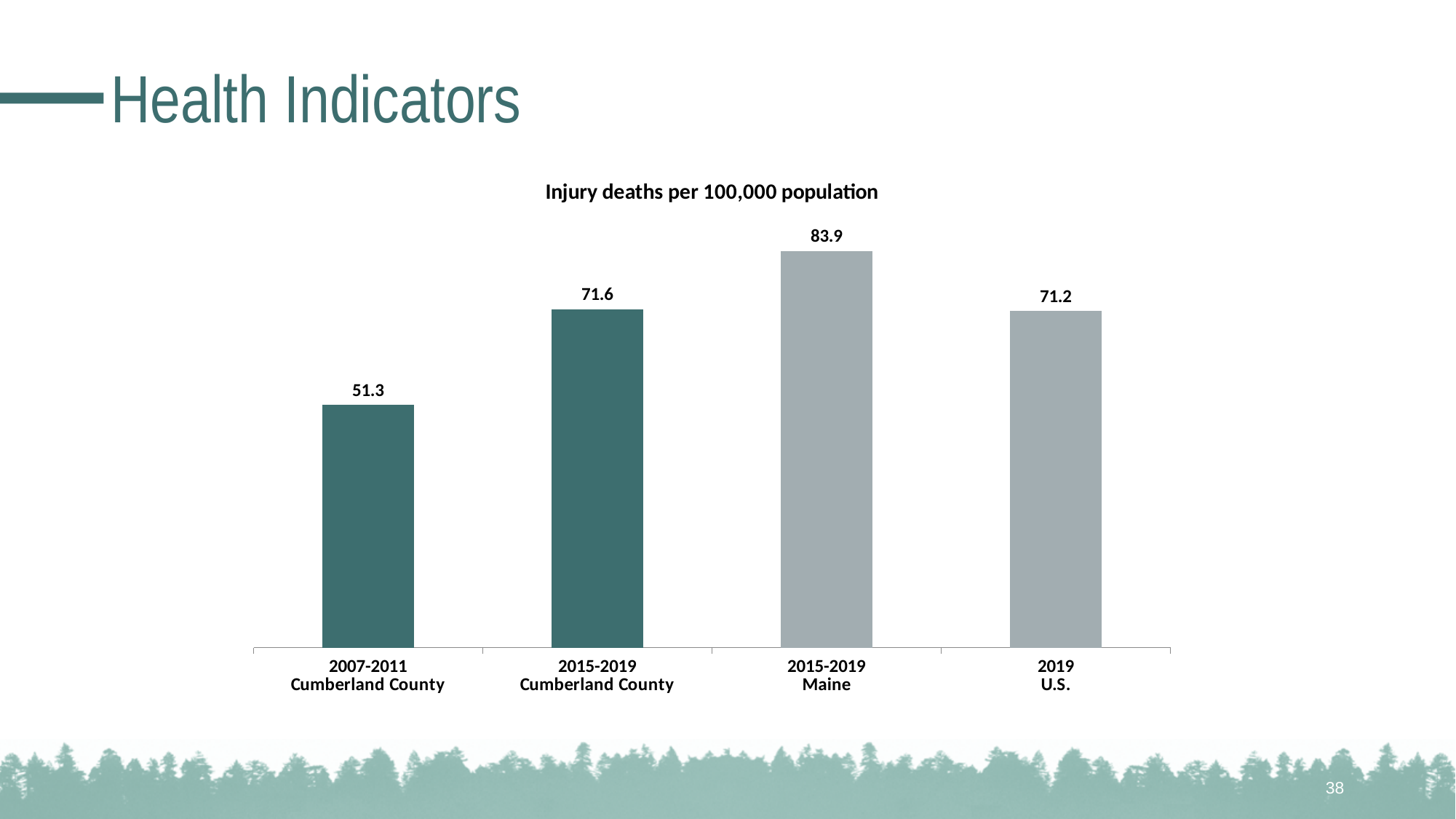
How many categories are shown in the chart? 4 Which is larger, the value for 2015-2019 Maine or the value for 2015-2019 Cumberland County? 2015-2019 Maine What is the value for 2015-2019 Maine? 83.9 Which category has the lowest value? 2007-2011 Cumberland County What kind of chart is shown? Bar chart What is the title of the chart? Injury deaths per 100,000 population What is the value for 2019 U.S.? 71.2 What is the difference between the 2015-2019 Maine value and the 2019 U.S. value? 12.7 What is the value for 2015-2019 Cumberland County? 71.6 What is the value for 2007-2011 Cumberland County? 51.3 Which category has the highest value? 2015-2019 Maine What is the difference between the 2015-2019 Cumberland County value and the 2007-2011 Cumberland County value? 20.3